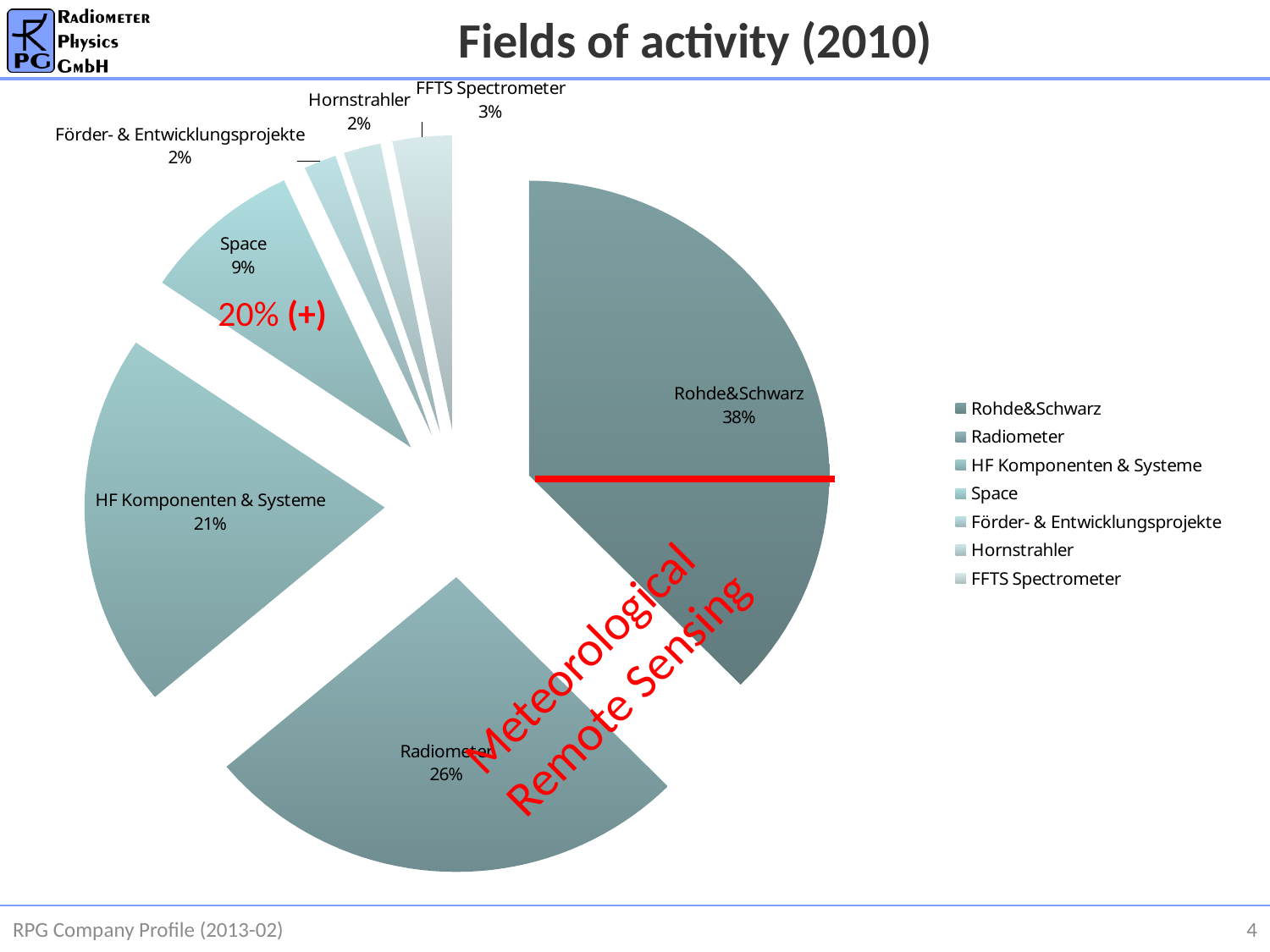
What share of the pie does HF Komponenten & Systeme have? 21% What is the title of the chart? Fields of activity (2010) Which is larger, the share for Radiometer or the share for HF Komponenten & Systeme? Radiometer What share of the pie does FFTS Spectrometer have? 3% Which category has the largest slice of the pie? Rohde&Schwarz Which category has the smallest slice of the pie, Space or FFTS Spectrometer? FFTS Spectrometer What kind of chart is shown on the slide? pie chart What is the difference in percentage points between Rohde&Schwarz and Radiometer? 12 What share of the pie does Space have? 9% What share of the pie does Radiometer have? 26% How many categories does the legend list? 7 What share of the pie does Rohde&Schwarz have? 38%